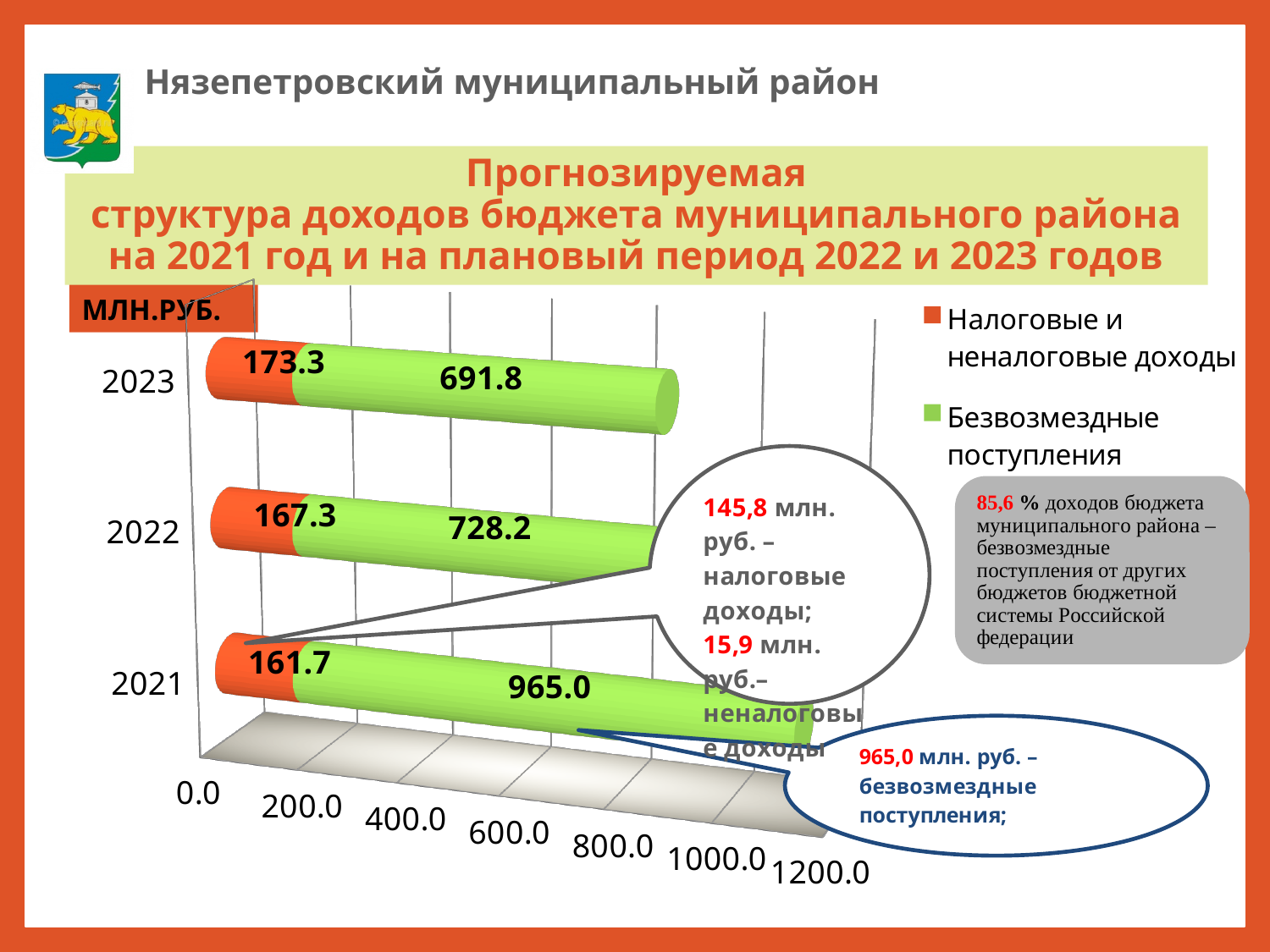
What is the total of the stacked bar for 2023? 865.1 Which year has the lowest value for Налоговые и неналоговые доходы? 2021 What is the value of Налоговые и неналоговые доходы for 2021? 161.7 How many series does the legend list? 2 What is the difference between Безвозмездные поступления in 2021 and in 2022? 236.8 What is the total of the stacked bar for 2021? 1126.7 What kind of chart is shown on the slide? Stacked bar chart What is the value of Безвозмездные поступления for 2023? 691.8 What is the value of Безвозмездные поступления for 2022? 728.2 Which is larger: Налоговые и неналоговые доходы in 2023 or in 2022? 2023 Which year has the highest value for Безвозмездные поступления? 2021 How many years are shown on the chart? 3